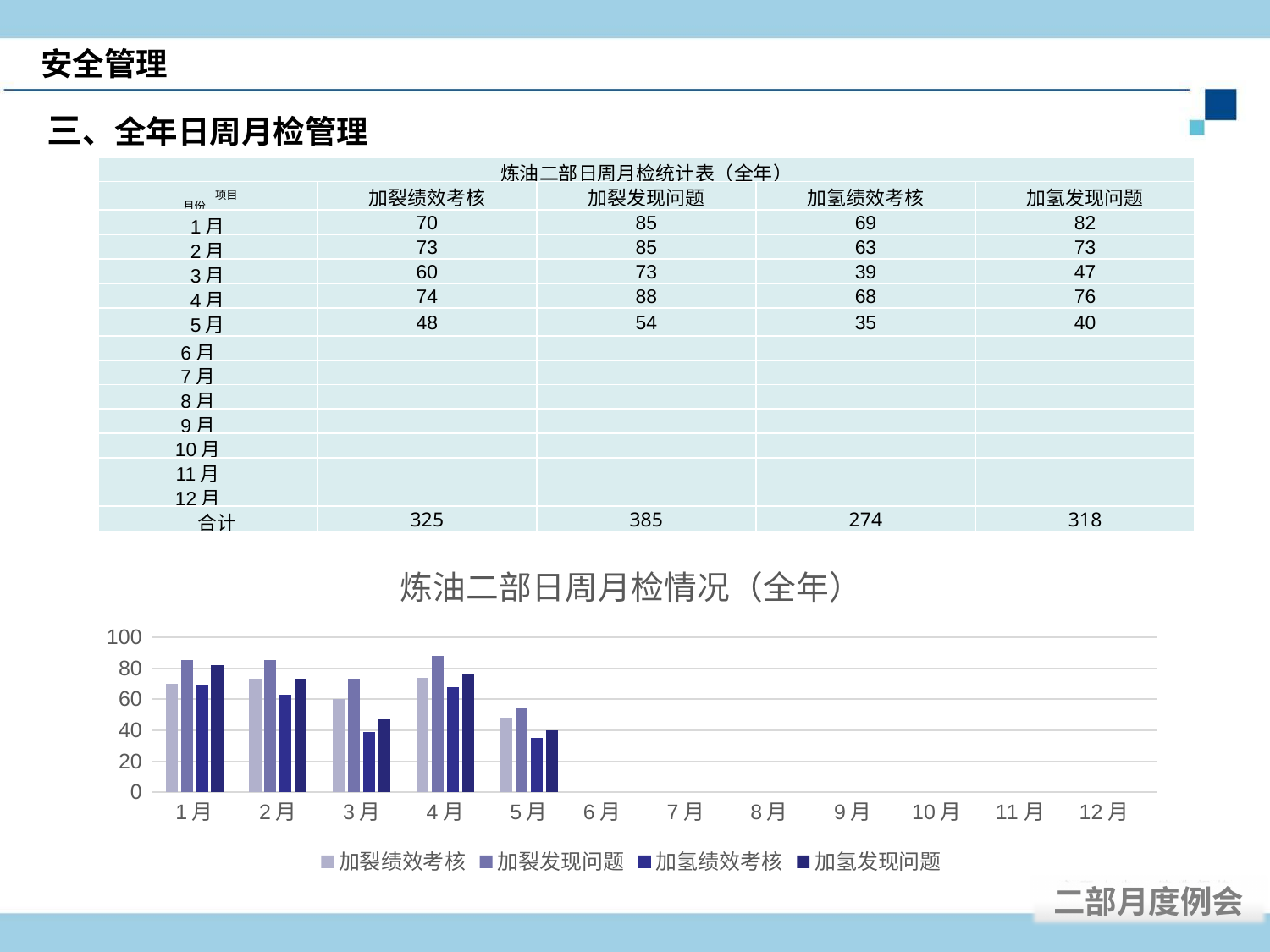
For the 加裂绩效考核 series, which month has the lowest bar? 5月 What is the title of the chart? 炼油二部日周月检情况（全年） In 4月, which series has the highest bar? 加裂发现问题 How many series does the chart legend list? 4 What kind of chart is shown on the slide? bar chart How many month categories are shown on the x axis of the chart? 12 Is the value for 加氢绩效考核 in 5月 greater or less than 40? less Does the 加氢绩效考核 series rise or fall from 4月 to 5月? fall Is the value for 加氢发现问题 in 3月 greater or less than 60? less Is the value for 加裂发现问题 in 4月 greater or less than 80? greater In 1月, which is larger: 加裂发现问题 or 加氢绩效考核? 加裂发现问题